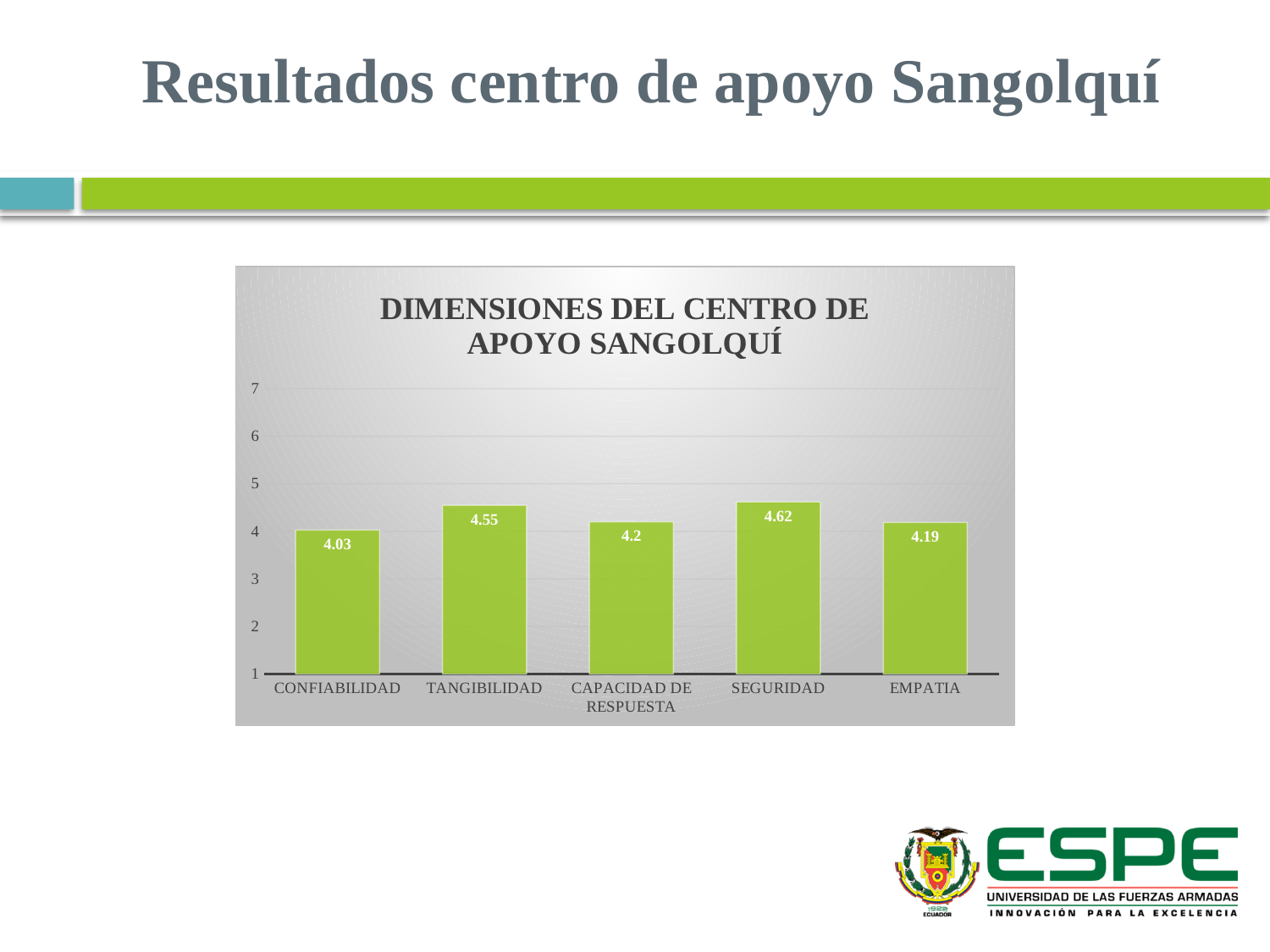
What is the difference between the values for SEGURIDAD and CONFIABILIDAD? 0.59 How many categories are shown in the chart? 5 What is the value for CONFIABILIDAD? 4.03 What is the value for EMPATIA? 4.19 What is the title of the chart? DIMENSIONES DEL CENTRO DE APOYO SANGOLQUÍ Which category has the lowest value? CONFIABILIDAD Which is larger, the value for TANGIBILIDAD or the value for EMPATIA? TANGIBILIDAD What kind of chart is shown on the slide? Bar chart Which category has the highest value? SEGURIDAD What is the value for TANGIBILIDAD? 4.55 What is the value for SEGURIDAD? 4.62 What is the value for CAPACIDAD DE RESPUESTA? 4.2